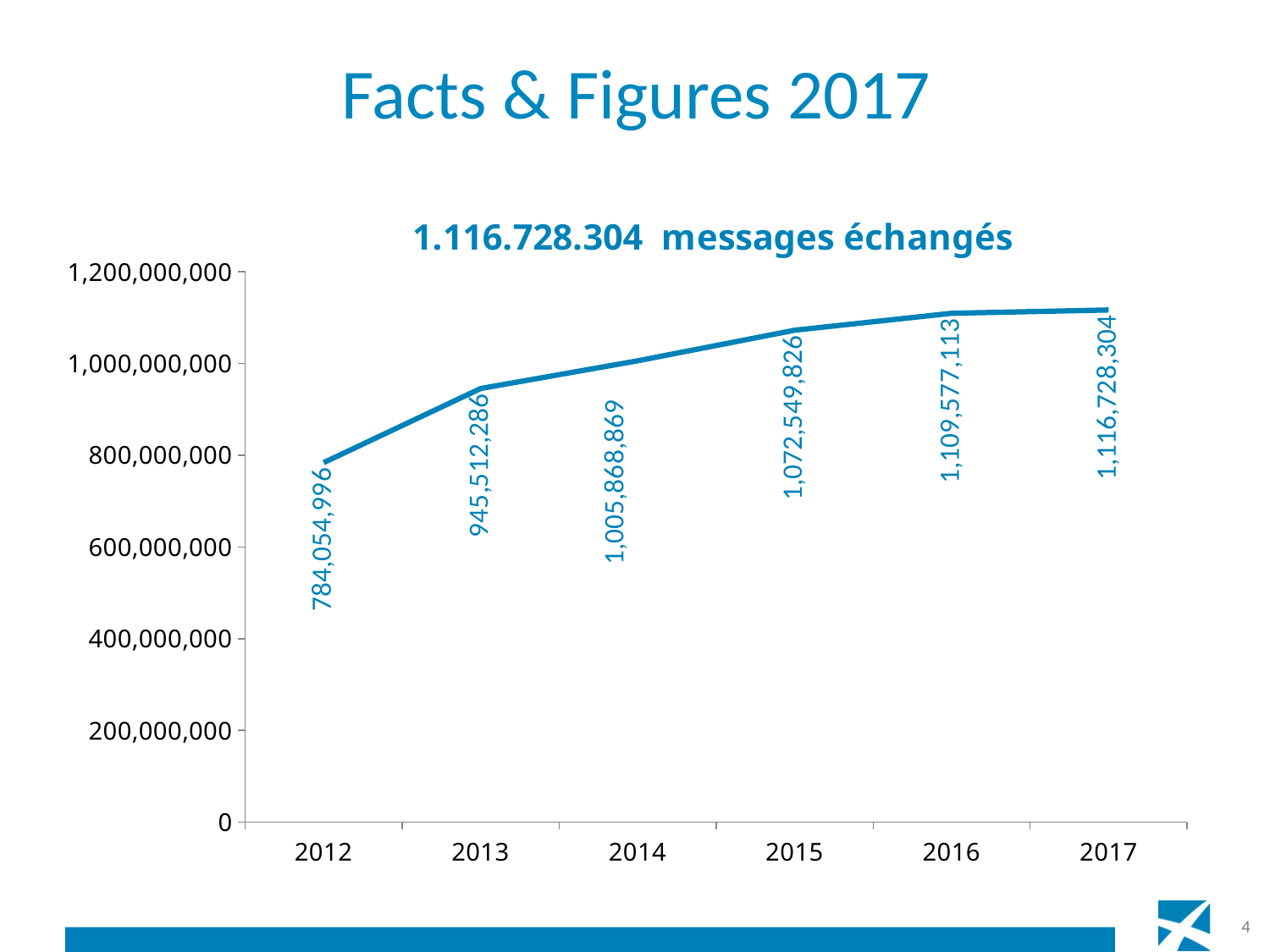
Which is larger, the value for 2014 or the value for 2015? 2015 Which year has the highest value? 2017 What is the value for 2016? 1,109,577,113 What kind of chart is shown on the slide? line chart What is the difference between the values for 2017 and 2012? 332,673,308 Which year has the lowest value? 2012 What is the difference between the values for 2013 and 2012? 161,457,290 What is the value for 2012? 784,054,996 Do the values rise or fall from 2012 to 2017? rise Is the value for 2013 greater or less than 1,000,000,000? less How many years are plotted on the chart? 6 What is the value for 2014? 1,005,868,869